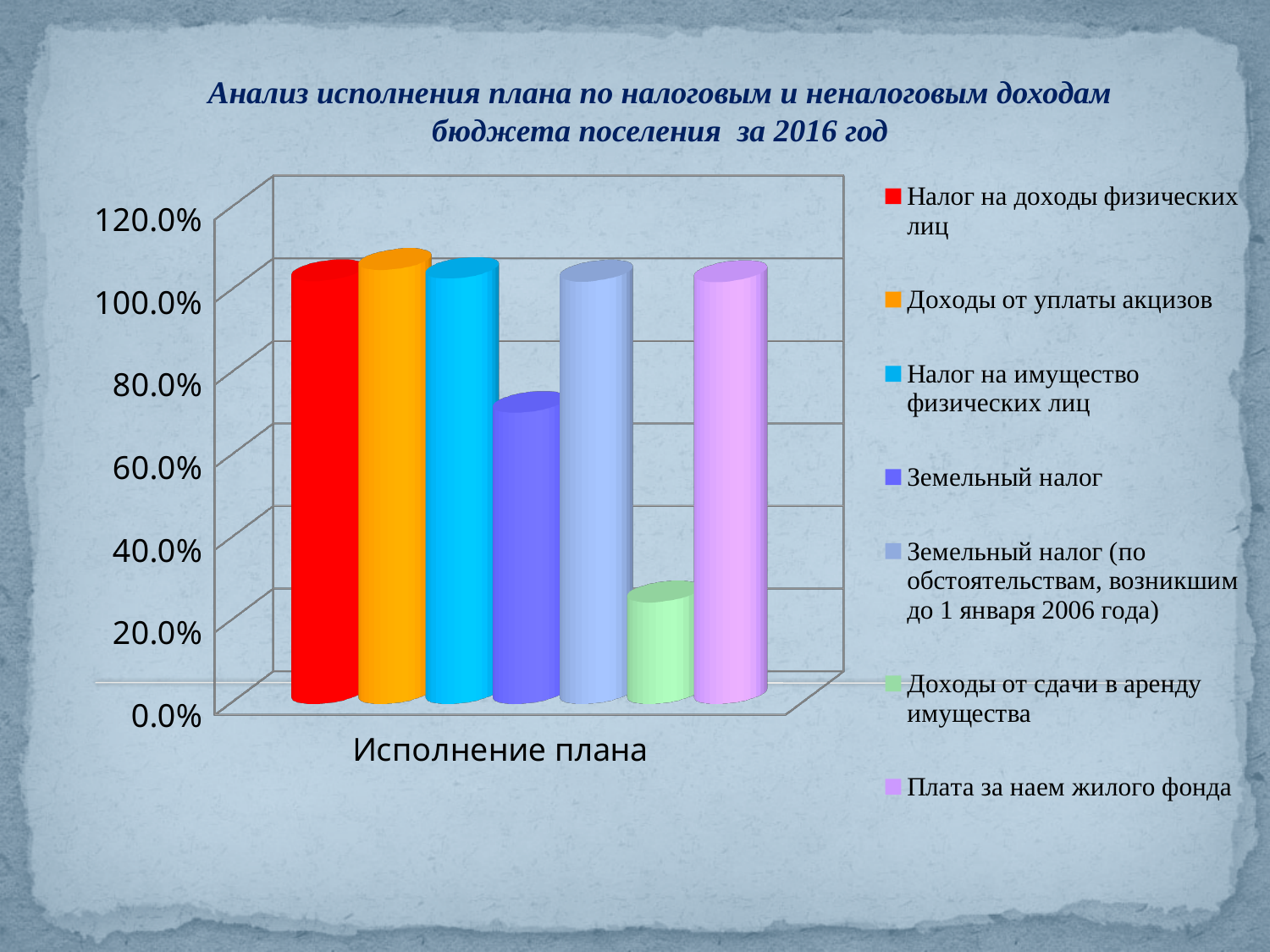
What kind of chart is shown on the slide? bar chart Which is larger: the value for Налог на имущество физических лиц or the value for Земельный налог? Налог на имущество физических лиц Is the value for Налог на доходы физических лиц greater or less than 80.0%? greater How many series does the legend list? 7 What is the label on the x axis of the chart? Исполнение плана Is the value for Доходы от сдачи в аренду имущества greater or less than 40.0%? less Is the value for Земельный налог greater or less than 60.0%? greater How many categories are shown on the x axis? 1 What is the title of the chart? Анализ исполнения плана по налоговым и неналоговым доходам бюджета поселения за 2016 год Which is larger: the value for Земельный налог or the value for Доходы от сдачи в аренду имущества? Земельный налог Which series has the lowest value? Доходы от сдачи в аренду имущества